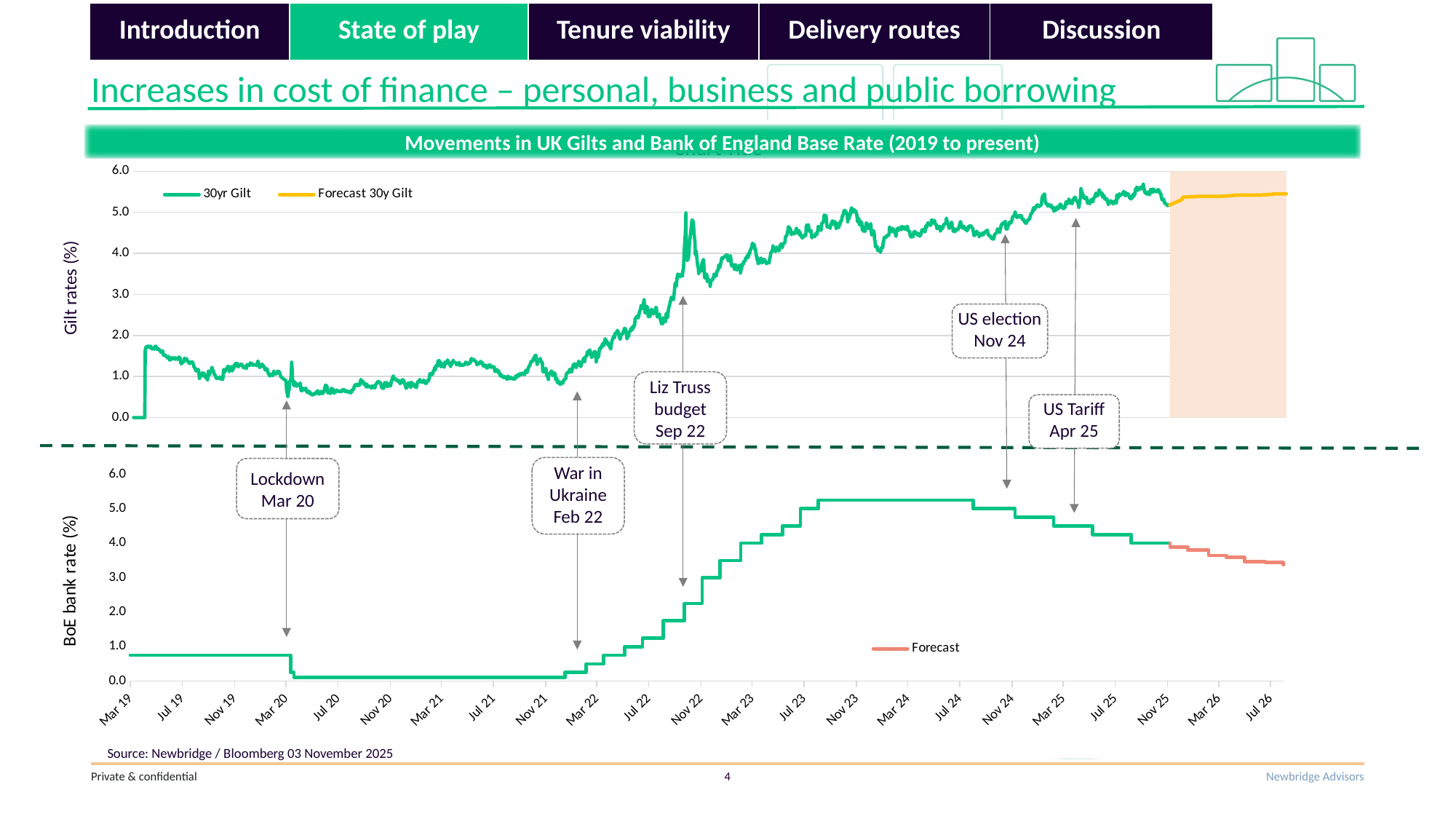
In the bottom chart (BoE bank rate), is the bank rate around Mar 21 greater or less than 1.0? less In the top chart (Gilt rates), does the 30yr Gilt rise or fall between Mar 22 and Nov 22? rise What kind of chart is the bottom chart (BoE bank rate)? Line chart How many series does the legend of the top chart (Gilt rates) list? 2 In the top chart (Gilt rates), is the 30yr Gilt value around Nov 25 greater or less than 5.0? greater In the bottom chart (BoE bank rate), does the bank rate rise or fall between Nov 24 and Nov 25? fall What is the title shown above the charts? Movements in UK Gilts and Bank of England Base Rate (2019 to present) In the top chart (Gilt rates), is the 30yr Gilt value around Mar 19 greater or less than 2.0? less What are the two series named in the legend of the top chart (Gilt rates)? 30yr Gilt and Forecast 30y Gilt What kind of chart is the top chart (Gilt rates)? Line chart